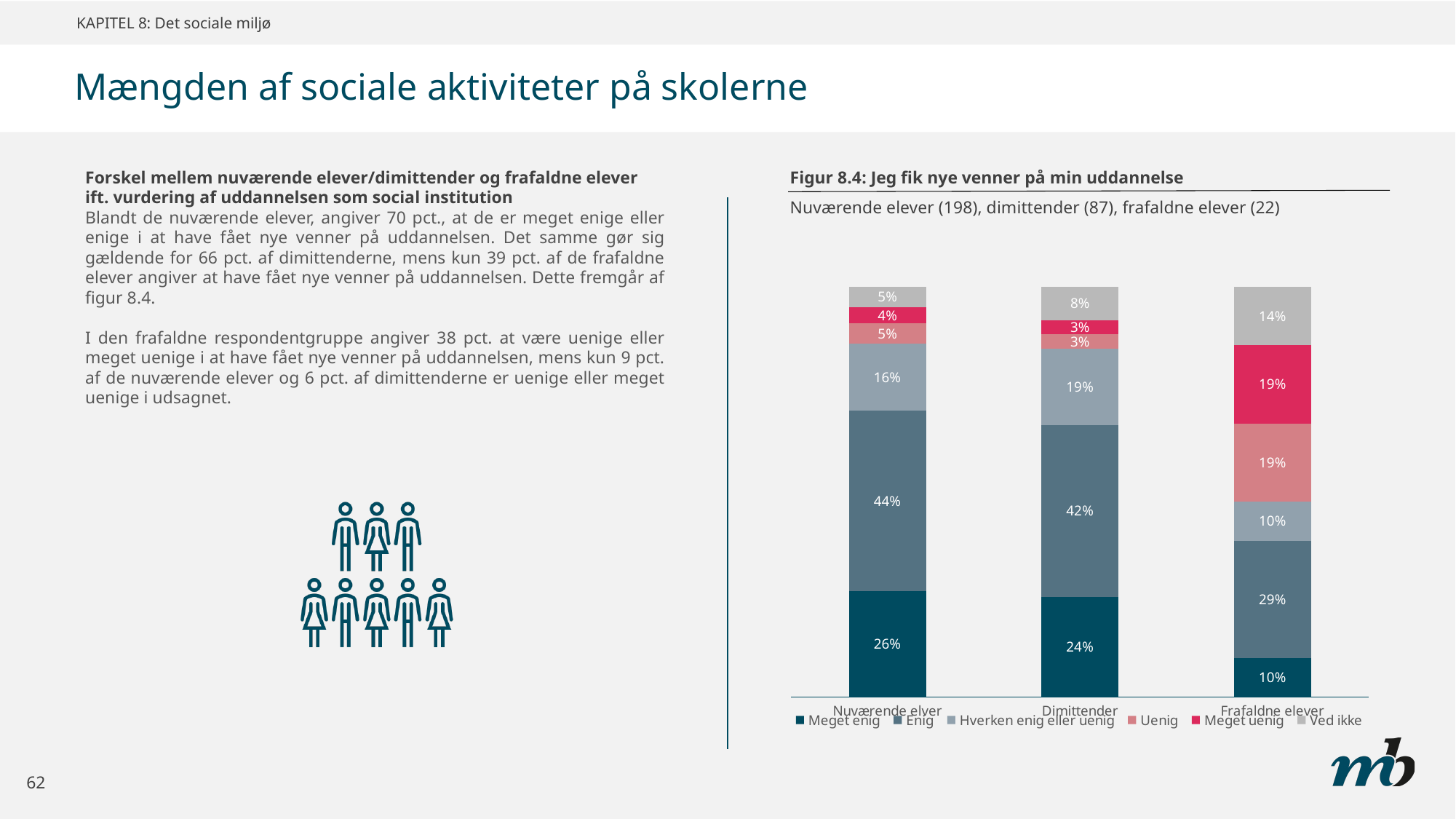
What is the value for 'Enig' among Dimittender? 42% What kind of chart is shown in Figur 8.4? stacked bar chart How many categories are shown on the x axis of the chart? 3 How many series does the chart legend list? 6 Which is larger: the 'Hverken enig eller uenig' value for Dimittender or for Nuværende elever? Dimittender What is the title of the figure? Figur 8.4: Jeg fik nye venner på min uddannelse Which category has the lowest value for 'Meget enig'? Frafaldne elever What is the value for 'Meget uenig' among Frafaldne elever? 19% What is the difference between the 'Enig' values for Nuværende elever and Frafaldne elever? 15% Which category has the highest value for 'Enig'? Nuværende elever What is the value for 'Meget enig' among Nuværende elever? 26% What is the value for 'Ved ikke' among Dimittender? 8%